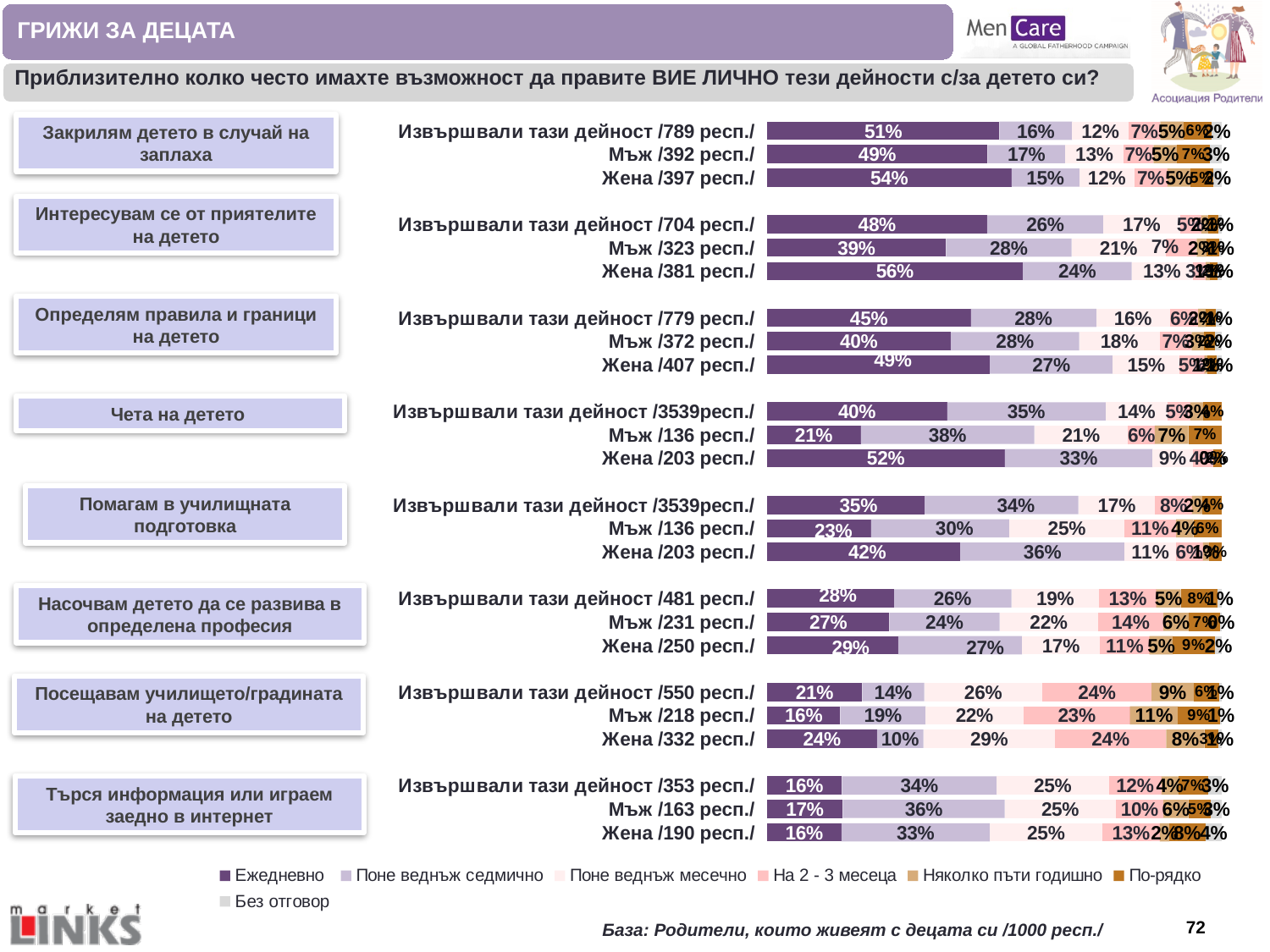
In the 'Чета на детето' group, what is the difference between the 'Ежедневно' values for 'Жена /203 респ./' and 'Мъж /136 респ./'? 31% In the 'Помагам в училищната подготовка' group, which has the larger 'Ежедневно' value: 'Мъж /136 респ./' or 'Жена /203 респ./'? Жена /203 респ./ What is the 'Ежедневно' value for 'Извършвали тази дейност' in the 'Закрилям детето в случай на заплаха' group? 51% In the 'Определям правила и граници на детето' group, what is the 'Поне веднъж седмично' value for 'Извършвали тази дейност /779 респ./'? 28% What is the 'Ежедневно' value for 'Жена /381 респ./' in the 'Интересувам се от приятелите на детето' group? 56% What is the 'Поне веднъж седмично' value for 'Мъж /136 респ./' in the 'Чета на детето' group? 38% What is the 'Поне веднъж месечно' value for 'Жена /332 респ./' in the 'Посещавам училището/градината на детето' group? 29% Among the 'Извършвали тази дейност' rows, which activity has the lowest 'Ежедневно' value? Търся информация или играем заедно в интернет How many series does the legend list? 7 What is the base stated at the bottom of the slide? Родители, които живеят с децата си /1000 респ./ Among the 'Извършвали тази дейност' rows, which activity has the highest 'Ежедневно' value? Закрилям детето в случай на заплаха What kind of chart is shown on the slide? Stacked bar chart